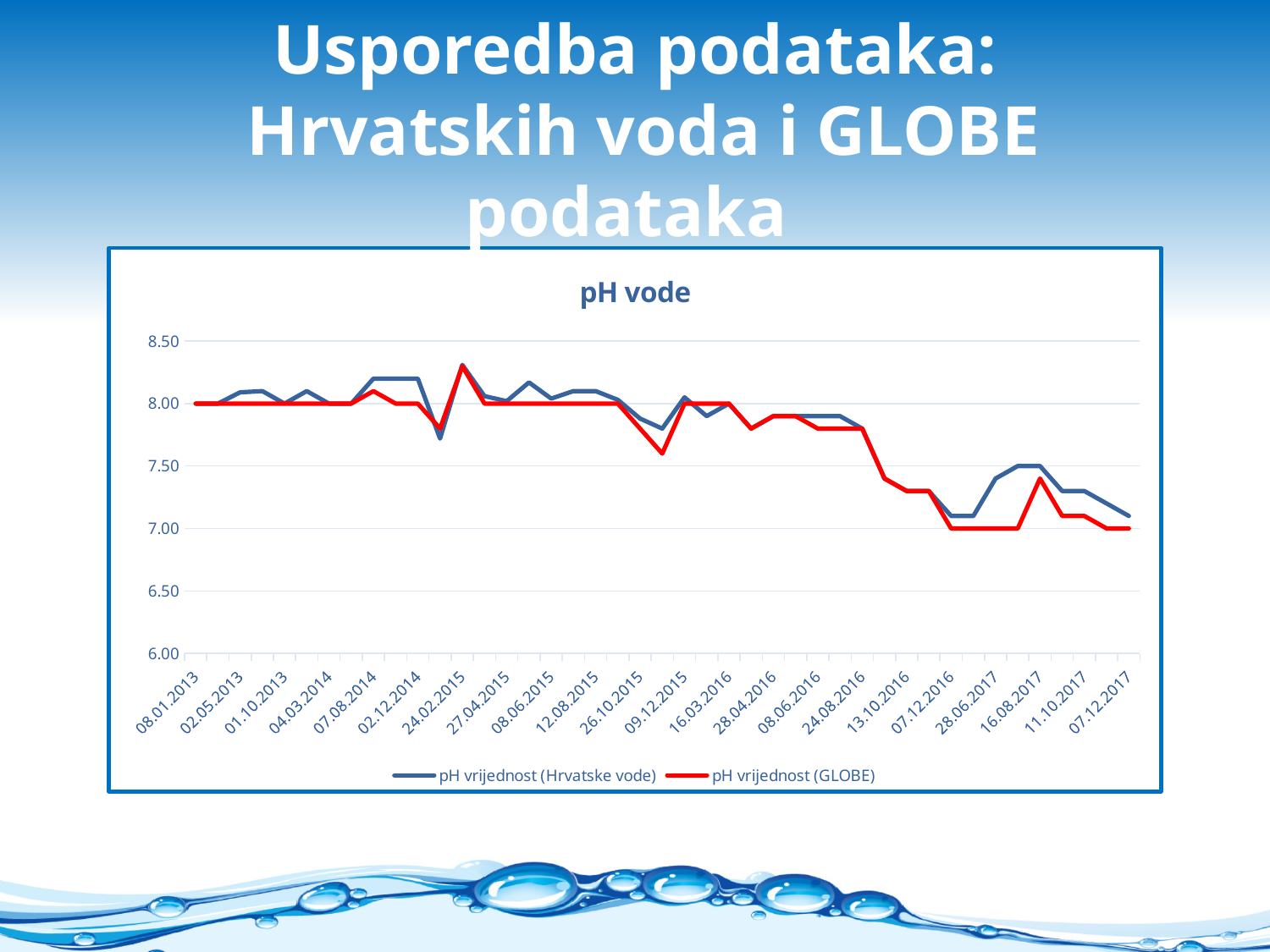
Which colour is used for the pH vrijednost (GLOBE) series? red What kind of chart is shown on the slide? line chart What is the pH vrijednost (GLOBE) value at 08.01.2013? 8.00 Which series has the higher value at 11.10.2017? pH vrijednost (Hrvatske vode) Is the pH vrijednost (Hrvatske vode) value at 07.12.2017 greater or less than 7.50? less Is the pH vrijednost (GLOBE) value at 24.02.2015 greater or less than 8.00? greater How many series does the chart legend list? 2 What is the pH vrijednost (GLOBE) value at 07.12.2017? 7.00 Do the pH values generally rise or fall from 08.01.2013 to 07.12.2017? fall What is the title of the chart? pH vode At which date does the pH vrijednost (GLOBE) series reach its highest value? 24.02.2015 Is the pH vrijednost (Hrvatske vode) value at 13.10.2016 greater or less than 7.50? less